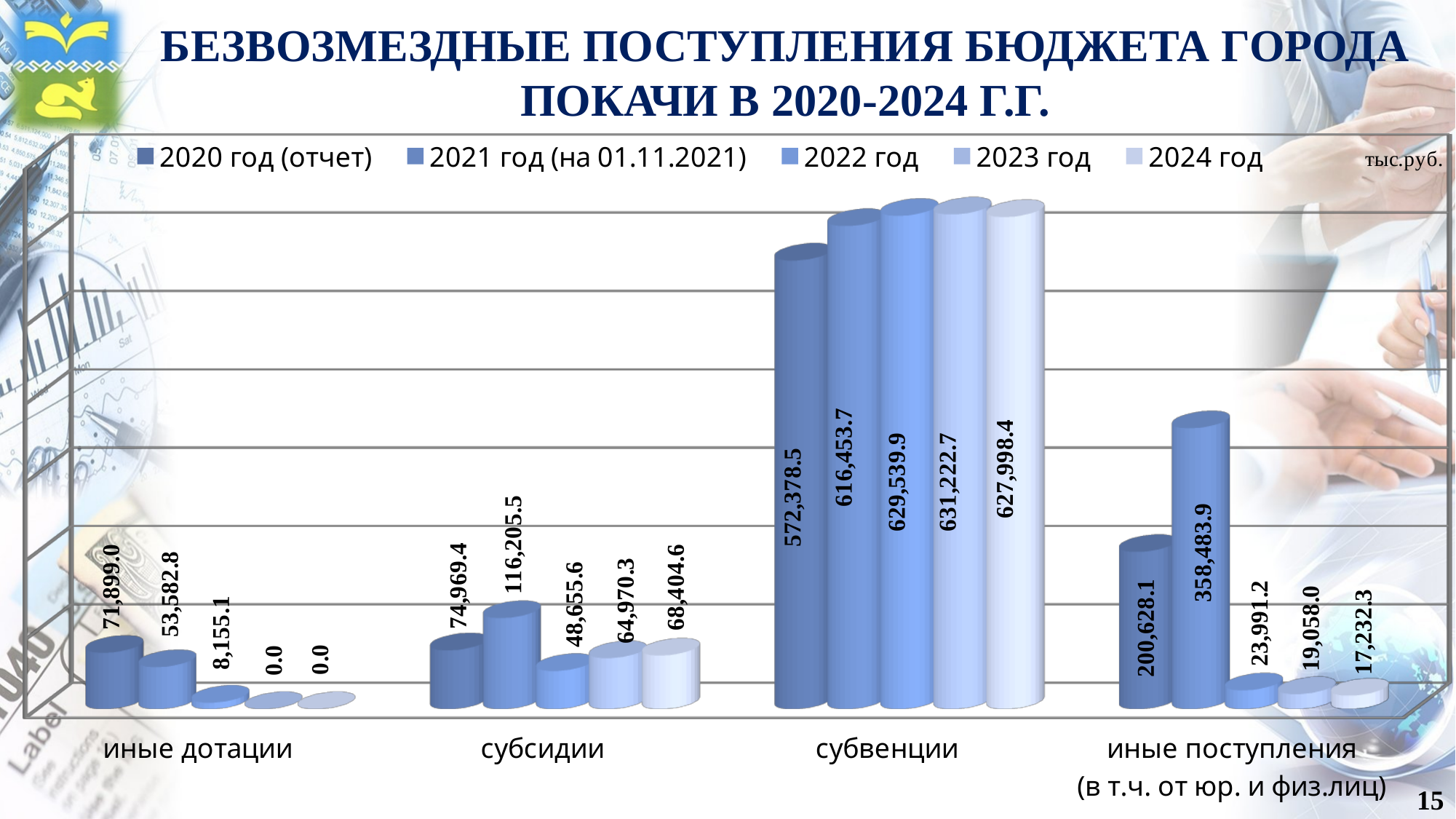
How many series does the legend list? 5 What is the value for иные поступления (в т.ч. от юр. и физ.лиц) in 2024 год? 17,232.3 What kind of chart is shown on the slide? Bar chart What is the value for субсидии in 2021 год (на 01.11.2021)? 116,205.5 Which year has the lowest value for субсидии? 2022 год How many categories are shown on the x axis? 4 Which year has the highest value for субвенции? 2023 год What is the difference between the 2021 год (на 01.11.2021) and 2020 год (отчет) values for иные поступления (в т.ч. от юр. и физ.лиц)? 157,855.8 What is the difference between the 2021 год (на 01.11.2021) and 2020 год (отчет) values for субсидии? 41,236.1 Which is larger for иные дотации: the 2020 год (отчет) value or the 2021 год (на 01.11.2021) value? 2020 год (отчет) What is the value for субвенции in 2022 год? 629,539.9 What is the value for иные дотации in 2020 год (отчет)? 71,899.0